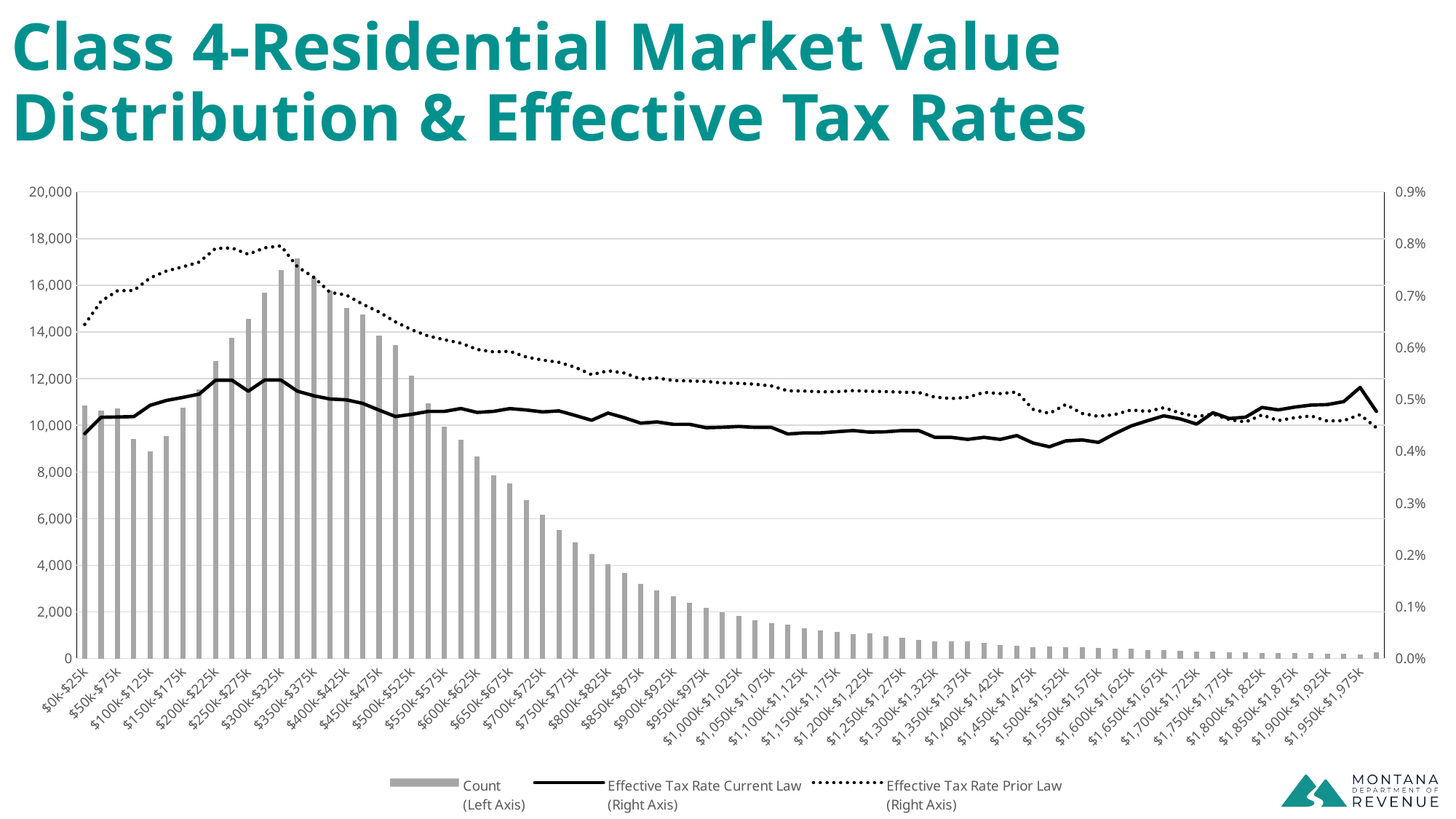
Is the Effective Tax Rate Current Law for the $0k-$25k bin greater or less than 0.5%? less Is the Count for the $900k-$925k bin greater or less than 2,000? greater Which axis does the Count series use, according to the legend? Left Axis Is the Count for the $200k-$225k bin greater or less than 12,000? greater At the $500k-$525k bin, which is higher: the Effective Tax Rate Current Law or the Effective Tax Rate Prior Law? Effective Tax Rate Prior Law Do the Count bars rise or fall along the x axis from $600k-$625k to $1,950k-$1,975k? fall How many series does the legend list? 3 What kind of chart is shown on the slide? Combined bar and line chart Which series is drawn as a dotted line? Effective Tax Rate Prior Law